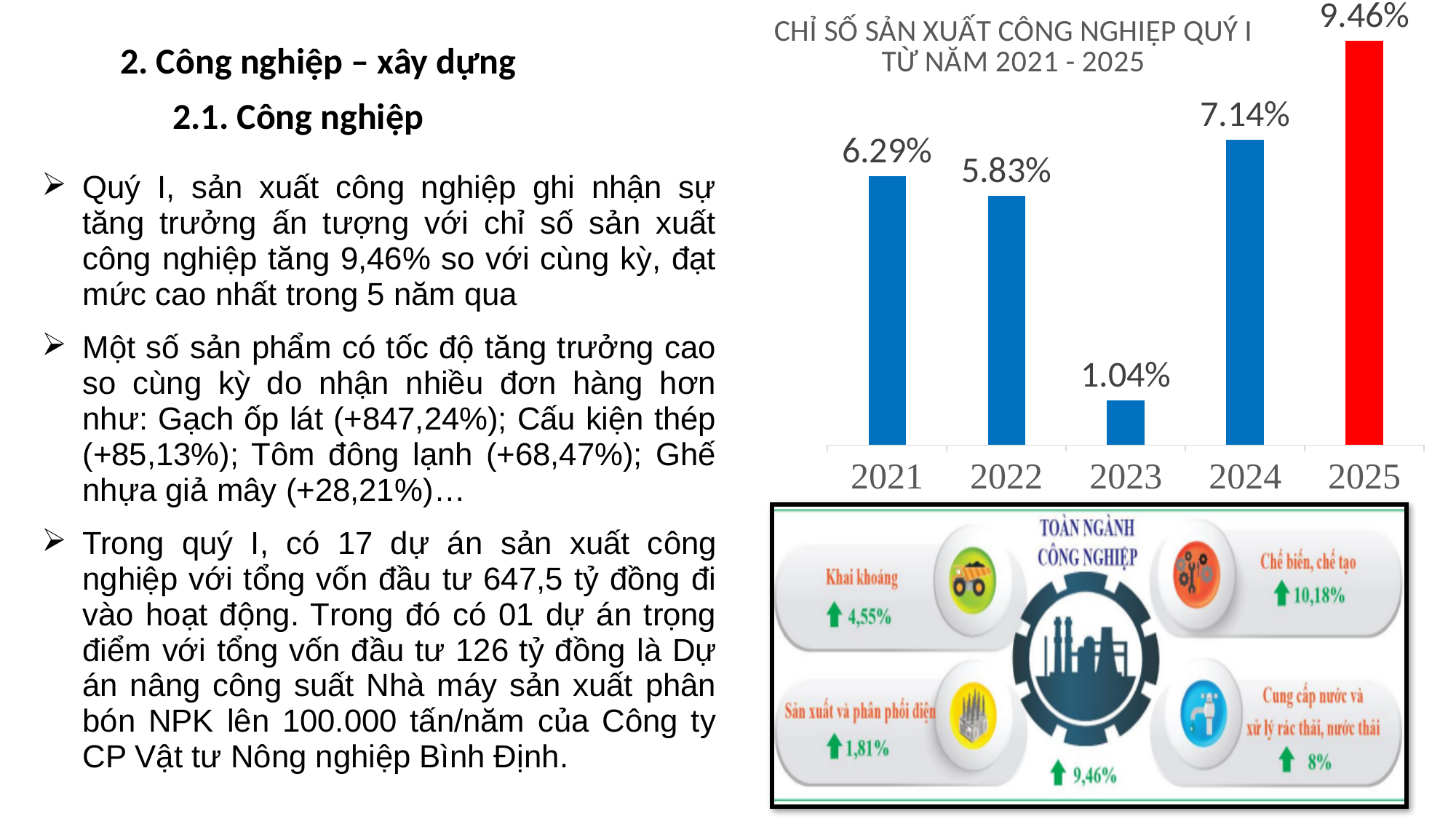
What is the value shown for 2022 in the chart? 5.83% What type of chart is used to show the industrial production index? Bar chart What is the difference between the values for 2025 and 2024? 2.32% What is the value shown for 2021 in the chart? 6.29% Which is larger, the value for 2024 or the value for 2021? 2024 How many years are shown on the x axis of the chart? 5 Which bar in the chart is coloured red rather than blue? 2025 What is the value shown for 2023 in the chart? 1.04% What is the difference between the values for 2021 and 2022? 0.46% Which year has the lowest value in the chart? 2023 Which year has the highest value in the chart? 2025 What is the value shown for 2025 in the chart? 9.46%